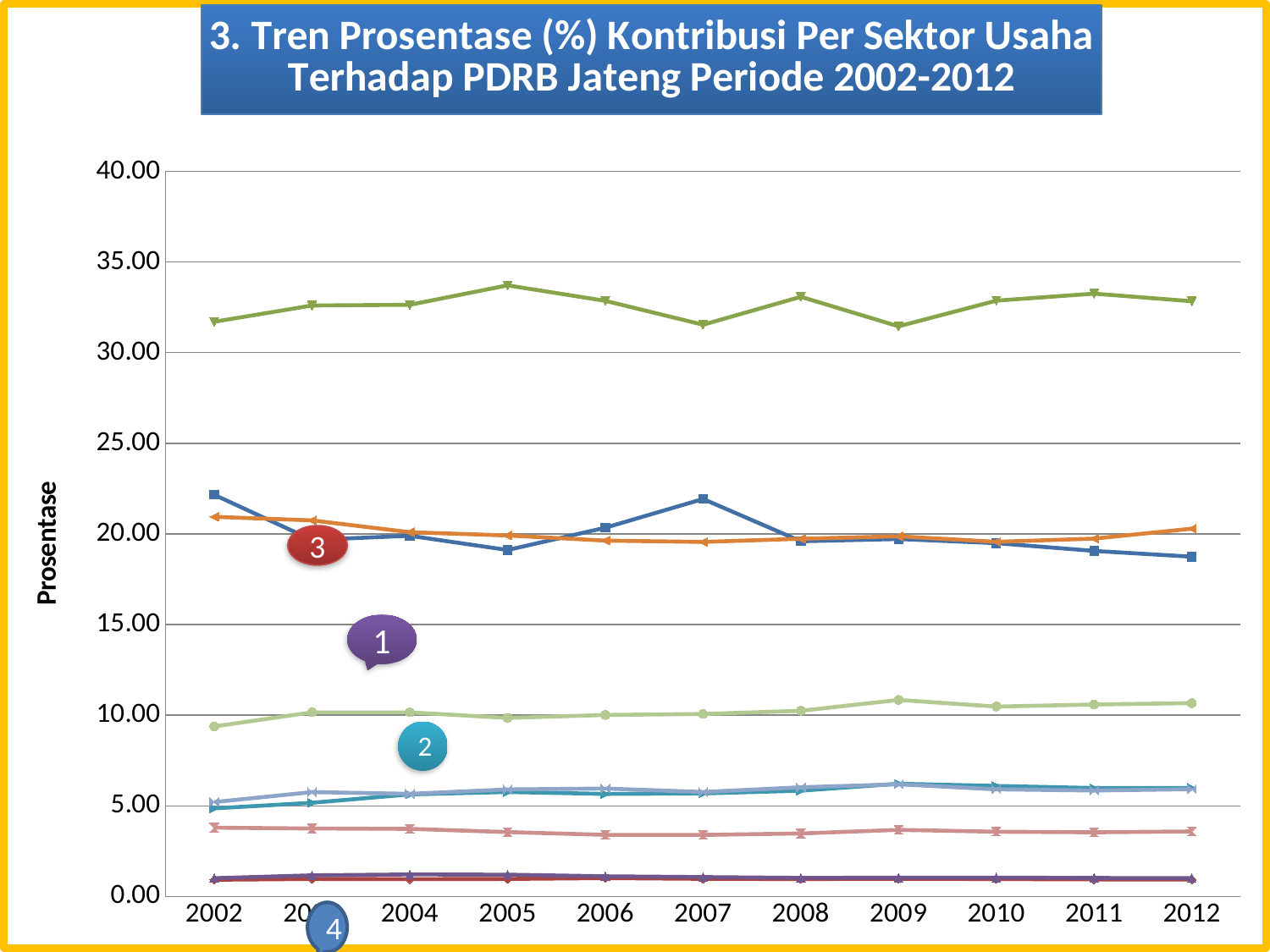
Is the value of the topmost (green) line in 2007 greater or less than 35.00? less Is the value of the dark blue line with square markers in 2002 greater or less than 20.00? greater Is the value of the topmost (green) line in 2005 greater or less than 30.00? greater Does the light green line with circle markers rise or fall overall from 2002 to 2012? rise Does the dark blue line with square markers rise or fall overall from 2002 to 2012? fall What is the maximum value shown on the y axis? 40.00 What kind of chart is shown on the slide? line chart How many years are shown along the x axis of the chart? 11 What is the first year shown on the x axis? 2002 What is the last year shown on the x axis? 2012